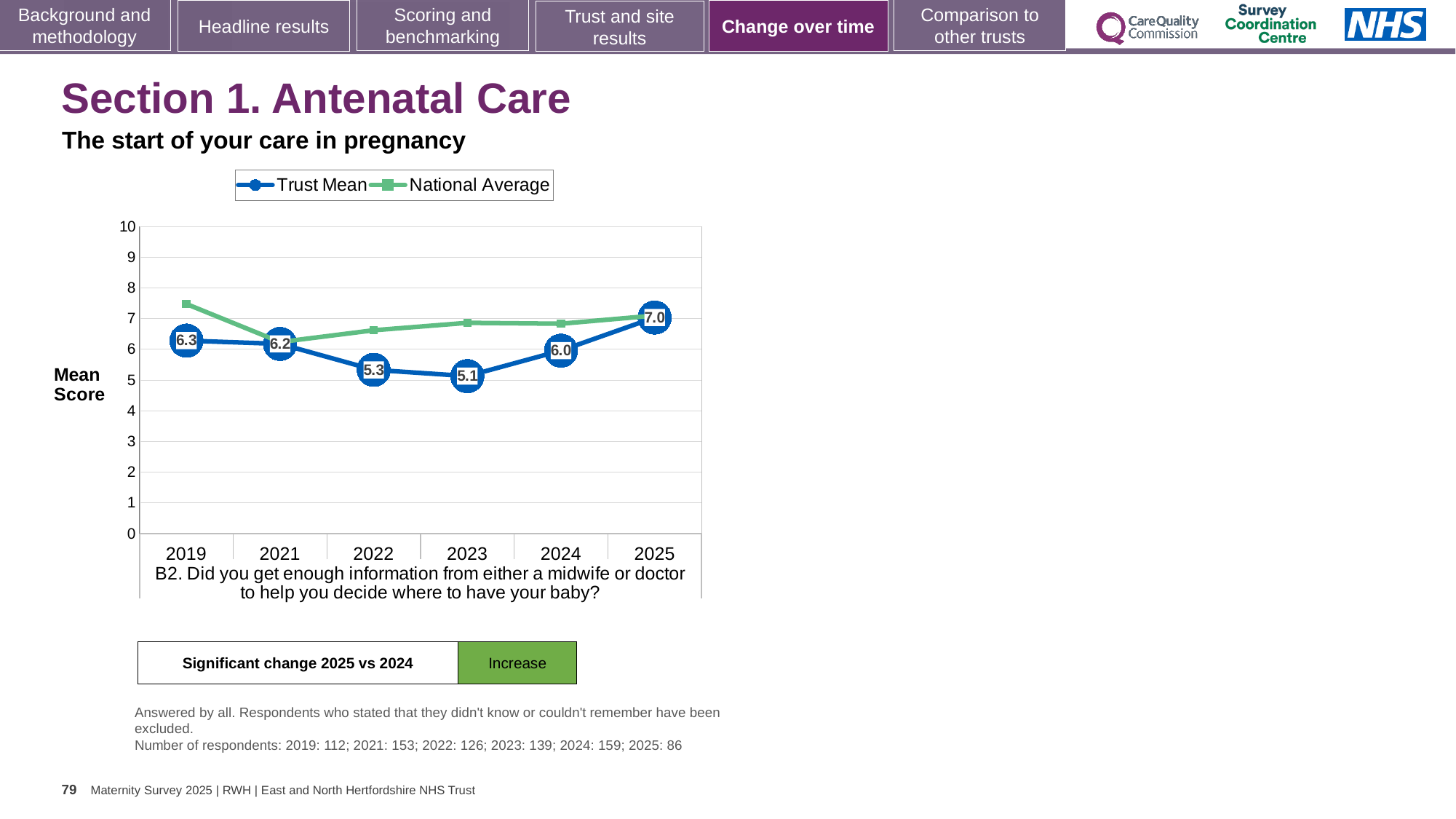
In which year is the Trust Mean score lowest? 2023 In which year is the Trust Mean score highest? 2025 What is the difference between the Trust Mean scores for 2025 and 2024? 1.0 How many years are shown on the x axis? 6 What is the Trust Mean score for 2023? 5.1 Which is larger, the Trust Mean score for 2022 or for 2024? 2024 How many series does the legend list? 2 Does the Trust Mean score rise or fall from 2023 to 2025? Rise What is the Trust Mean score for 2025? 7.0 What kind of chart is shown on the slide? Line chart Is the National Average value for 2019 greater or less than 7? greater What is the Trust Mean score for 2019? 6.3